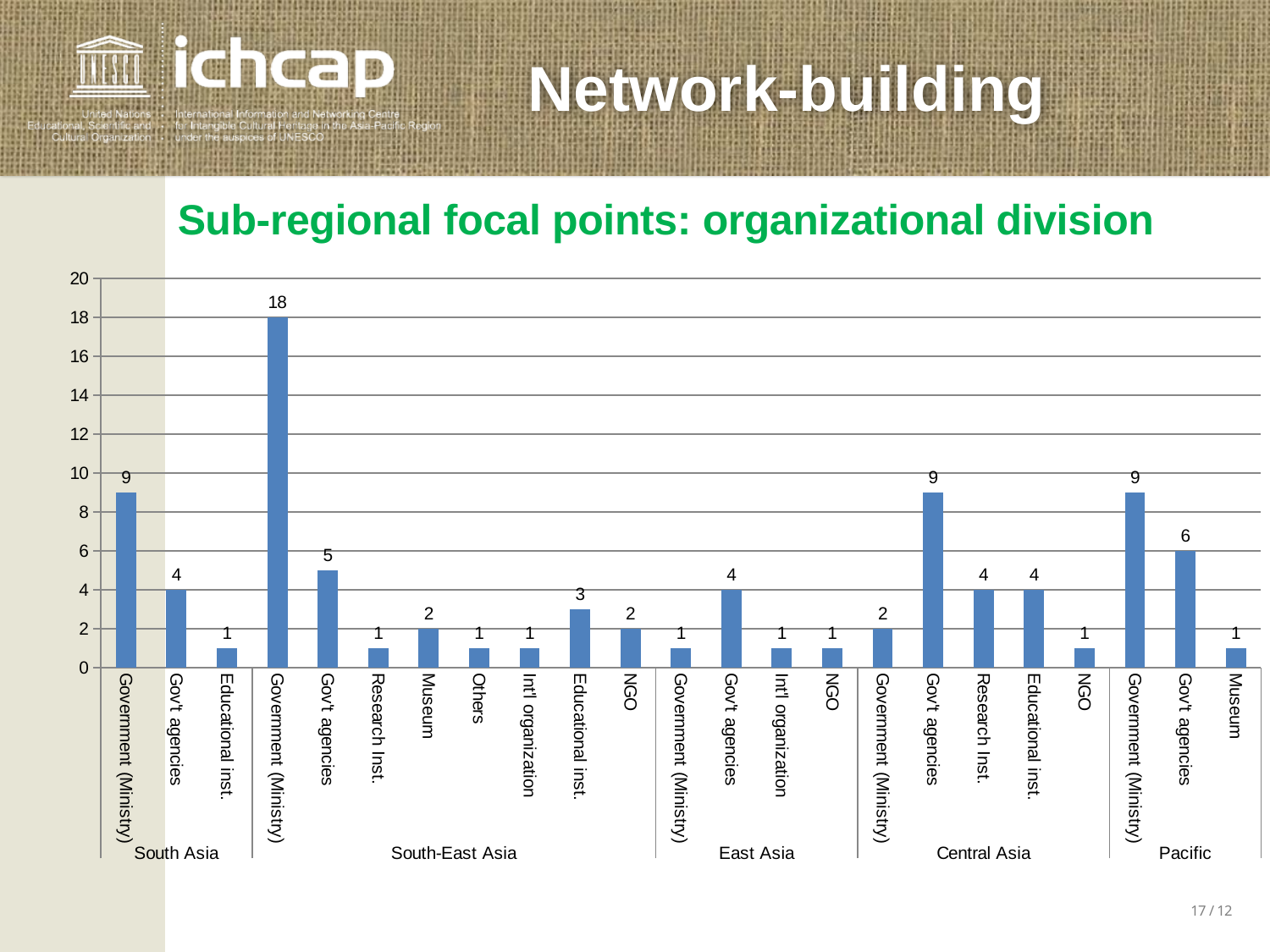
What is the value for Educational inst. in South-East Asia? 3 How many sub-regions are shown along the x axis? 5 Which is larger: Gov't agencies in the Pacific or Gov't agencies in South-East Asia? Gov't agencies in the Pacific Which bar has the highest value on the chart? Government (Ministry) in South-East Asia What is the value for Government (Ministry) in South-East Asia? 18 What kind of chart is shown on the slide? Bar chart Is the value for Government (Ministry) in South-East Asia greater or less than 16? greater How many bars are plotted on the chart? 23 What is the title of the chart? Sub-regional focal points: organizational division What is the value for Gov't agencies in Central Asia? 9 What is the value for Museum in the Pacific? 1 What is the difference between Government (Ministry) in South-East Asia and Government (Ministry) in South Asia? 9